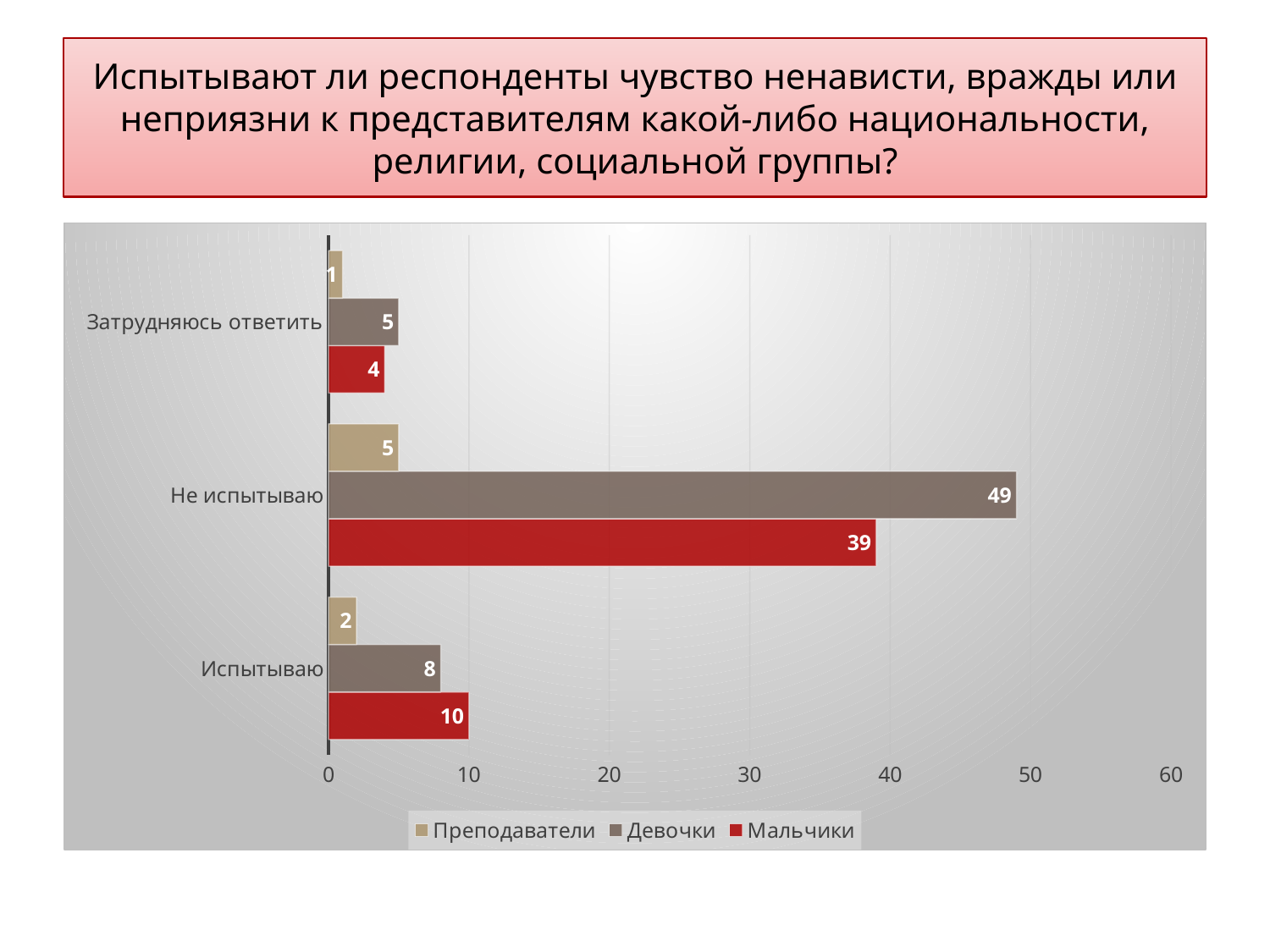
In the category Испытываю, which is larger: the value for Девочки or for Мальчики? Мальчики How many series does the legend list? 3 Which series is shown in red in the legend? Мальчики Which category has the highest value for Мальчики? Не испытываю What is the value for Мальчики in the category Испытываю? 10 Which category has the lowest value for Преподаватели? Затрудняюсь ответить What type of chart is shown on the slide? bar chart What is the value for Девочки in the category Не испытываю? 49 How many categories are shown on the chart? 3 What is the value for Преподаватели in the category Затрудняюсь ответить? 1 What is the difference between the Девочки and Мальчики values in the category Не испытываю? 10 Is the value for Мальчики in the category Не испытываю greater or less than 30? greater